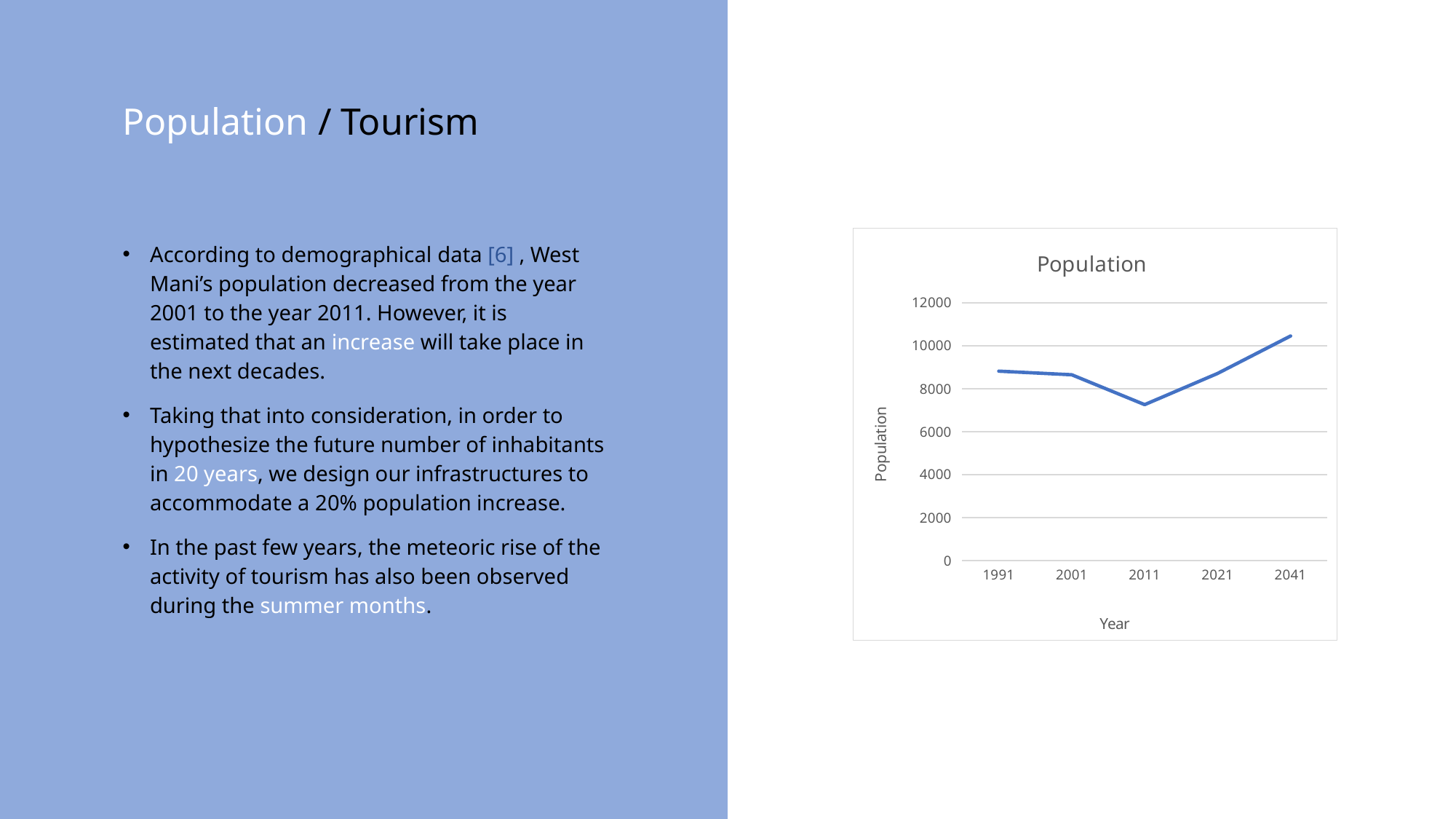
Which year has the lowest population value in the chart? 2011 Is the population value for 2021 greater or less than 10000? less What is the label of the x axis of the chart? Year How many years are plotted on the x axis of the chart? 5 Is the population value for 2011 greater or less than 8000? less Which year has the highest population value in the chart? 2041 Which year has the larger population value, 2011 or 2041? 2041 What kind of chart is shown on the slide? line chart Is the population value for 2041 greater or less than 10000? greater Does the population rise or fall from 2011 to 2041? rise What is the title of the chart? Population